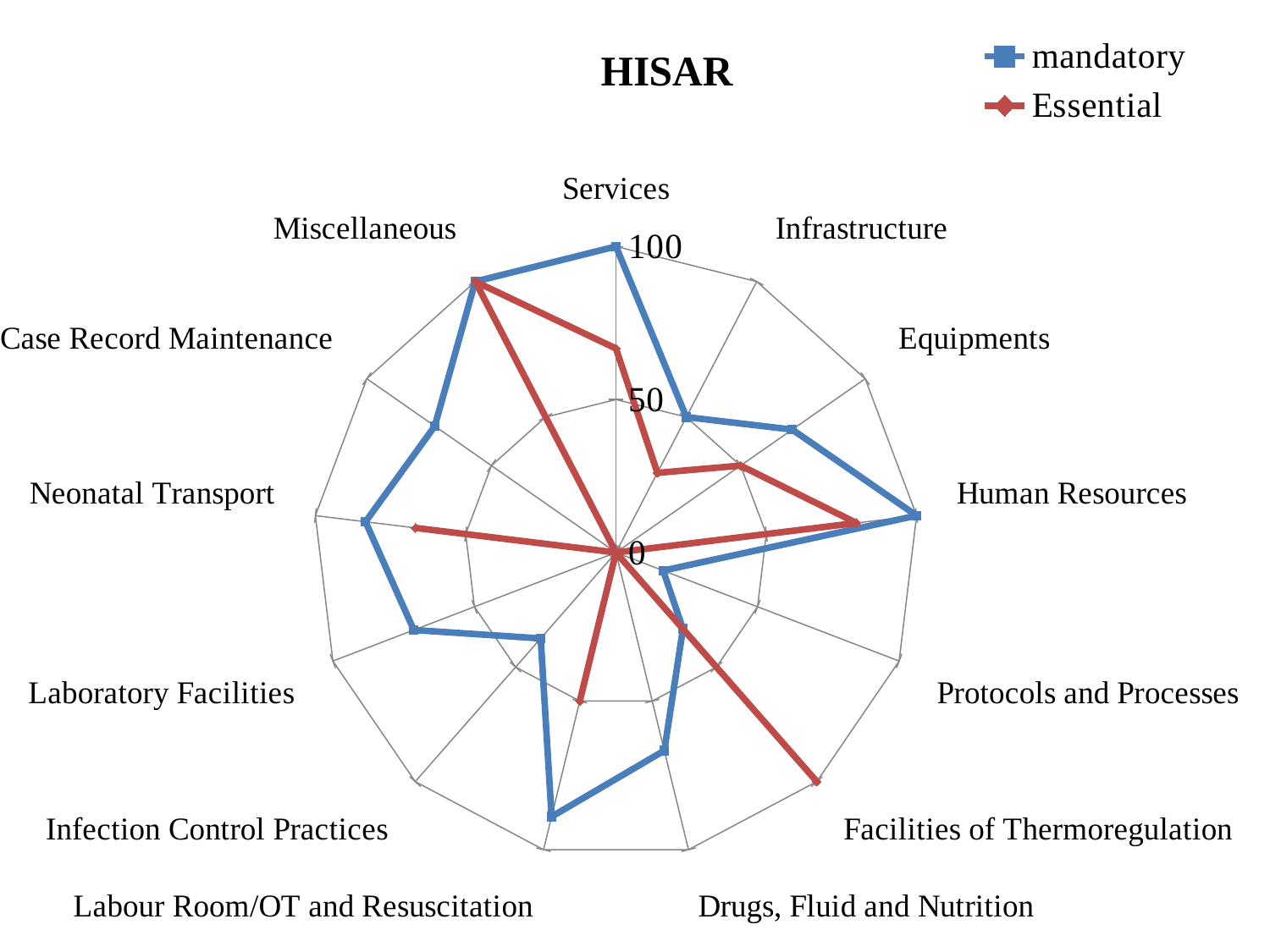
What is the mandatory value for Services? 100 For Facilities of Thermoregulation, which series has the larger value, mandatory or Essential? Essential Is the mandatory value for Neonatal Transport greater or less than 50? greater What kind of chart is shown on the slide? Radar chart How many series does the legend list? 2 What is the mandatory value for Human Resources? 100 How many categories (axes) does the radar chart have? 13 For Services, which series has the larger value, mandatory or Essential? mandatory What is the Essential value for Protocols and Processes? 0 Is the mandatory value for Protocols and Processes greater or less than 50? less What is the Essential value for Facilities of Thermoregulation? 100 What is the title of the chart? HISAR